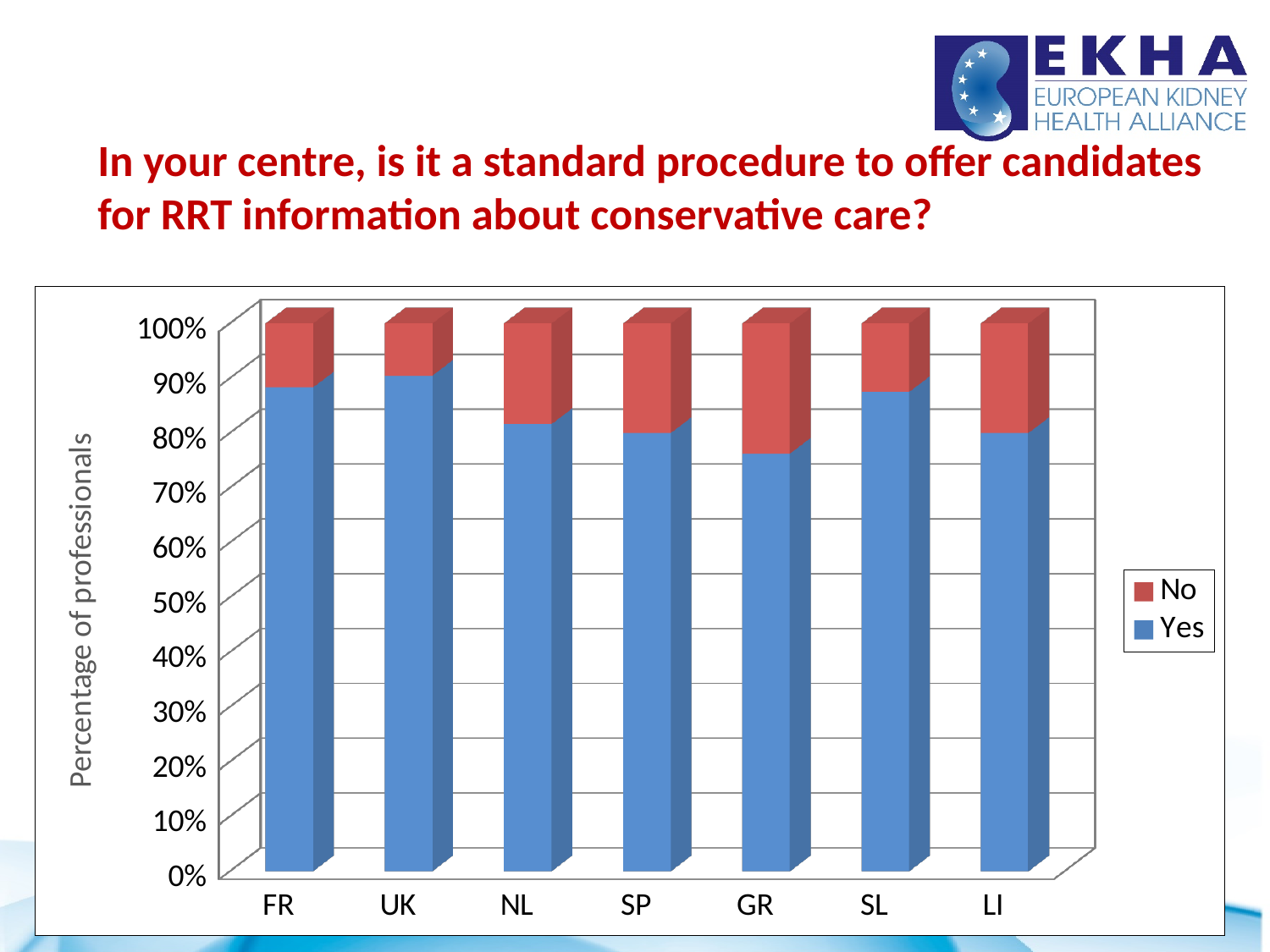
How many series does the chart's legend list? 2 Which country has the largest 'No' share? GR What are the two entries in the chart's legend? No and Yes Which country has the lowest 'Yes' share? GR What is the label of the vertical axis of the chart? Percentage of professionals Which has the larger 'Yes' share, UK or GR? UK What kind of chart is shown on the slide? Stacked bar chart Is the 'Yes' value for FR greater or less than 80%? greater Is the 'Yes' value for GR greater or less than 80%? less How many countries are shown on the x axis of the chart? 7 Is the 'Yes' value for SP greater or less than 70%? greater